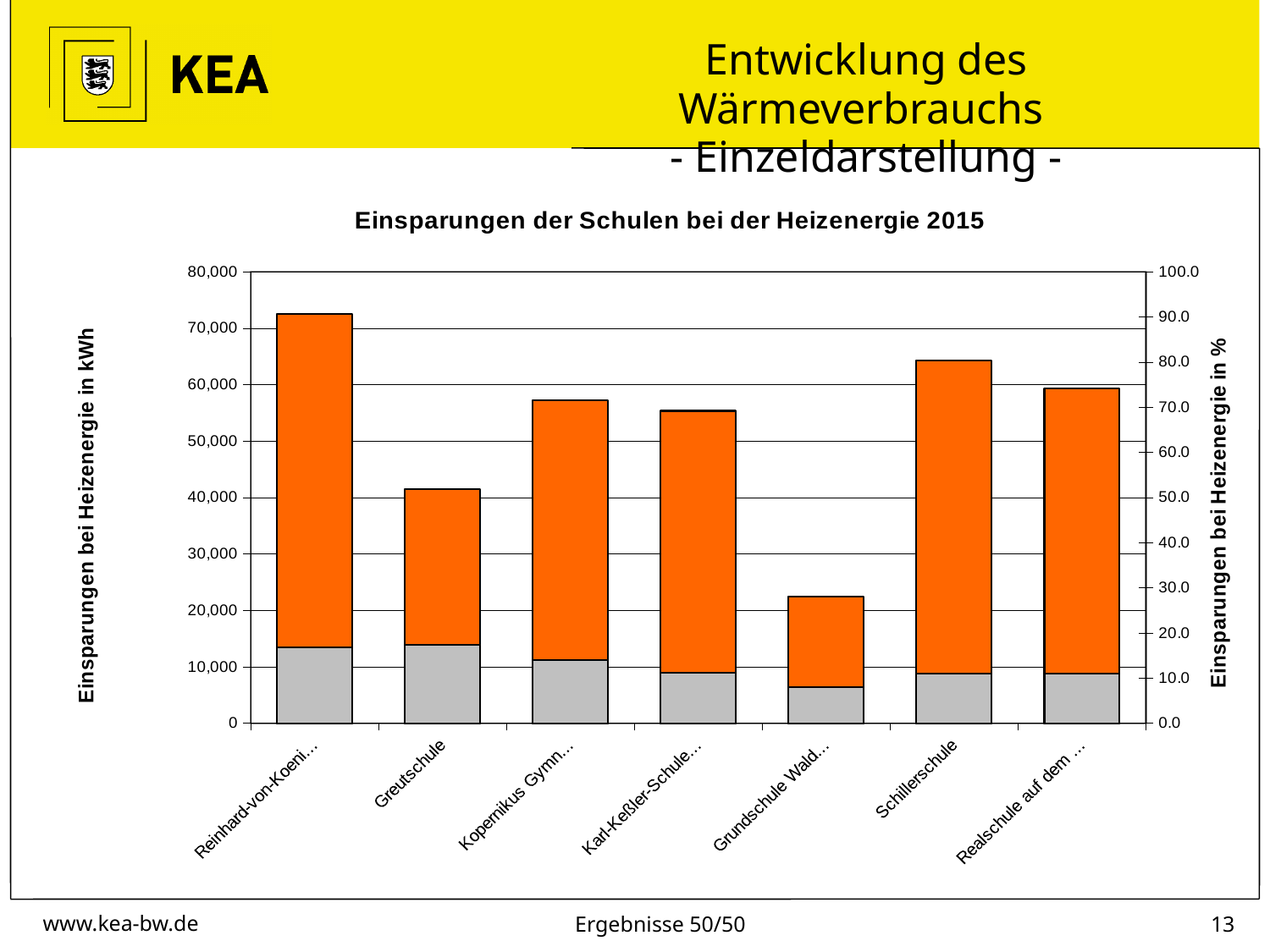
Is the orange bar for Greutschule greater or less than 50,000 kWh? less What is the title of the chart? Einsparungen der Schulen bei der Heizenergie 2015 Is the orange bar for Schillerschule greater or less than 70,000 kWh? less What is the highest value shown on the left vertical axis? 80,000 Which school has the taller orange bar, Greutschule or Schillerschule? Schillerschule Is the orange bar for Greutschule greater or less than 30,000 kWh? greater What is the label of the left vertical axis? Einsparungen bei Heizenergie in kWh What kind of chart is shown on the slide? bar chart How many schools (categories) are shown on the x axis of the chart? 7